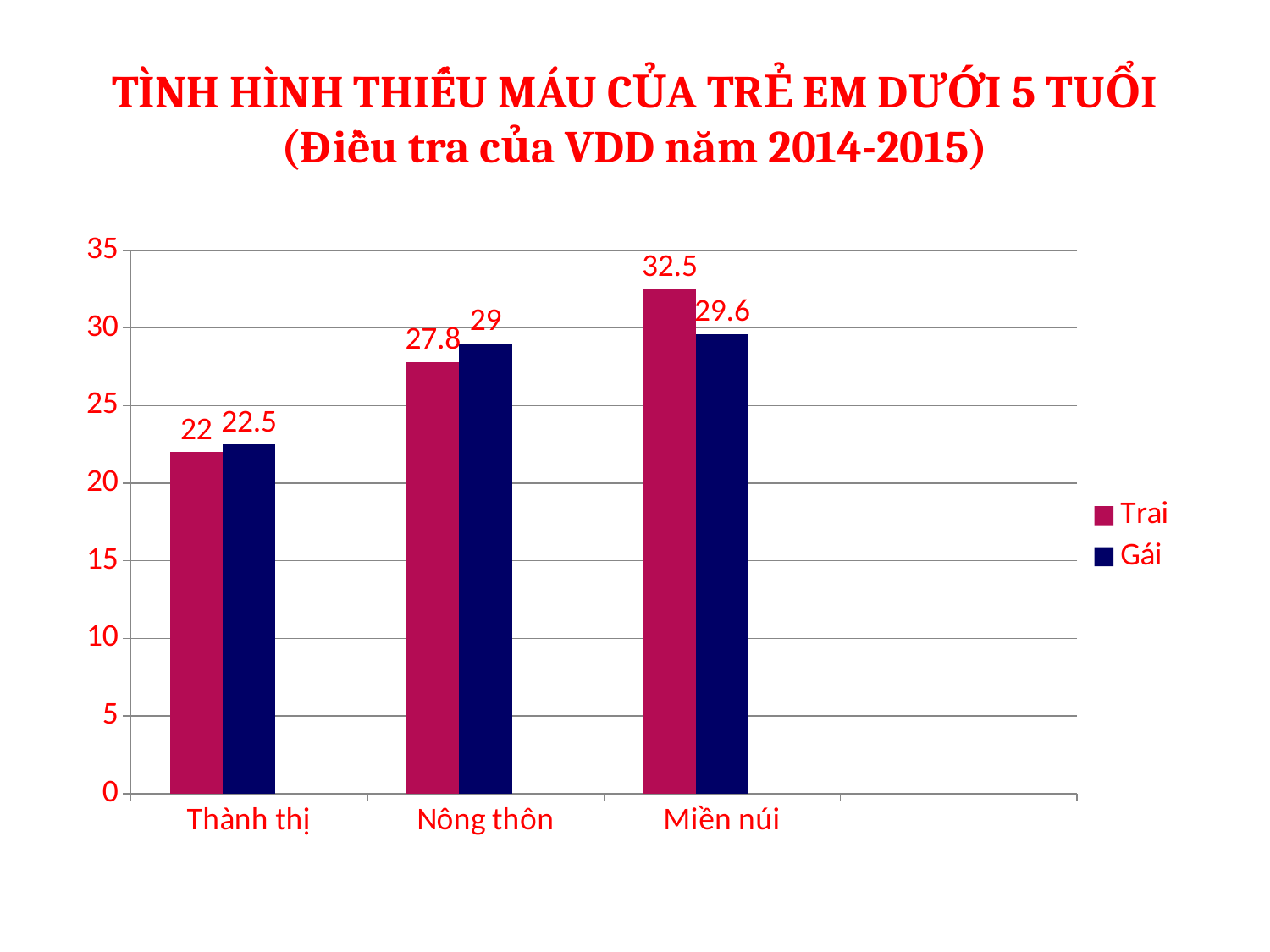
What is the value for Gái in Miền núi? 29.6 Which category has the lowest value for Gái? Thành thị How many series does the legend list? 2 What kind of chart is shown on the slide? Bar chart What is the value for Trai in Thành thị? 22 What is the difference between the Trai and Gái values in Miền núi? 2.9 Which is larger in Nông thôn, Trai or Gái? Gái What is the value for Gái in Nông thôn? 29 What is the value for Trai in Miền núi? 32.5 How many categories are shown on the x axis? 3 Which category has the highest value for Trai? Miền núi Do the Trai values rise or fall from Thành thị to Miền núi? Rise